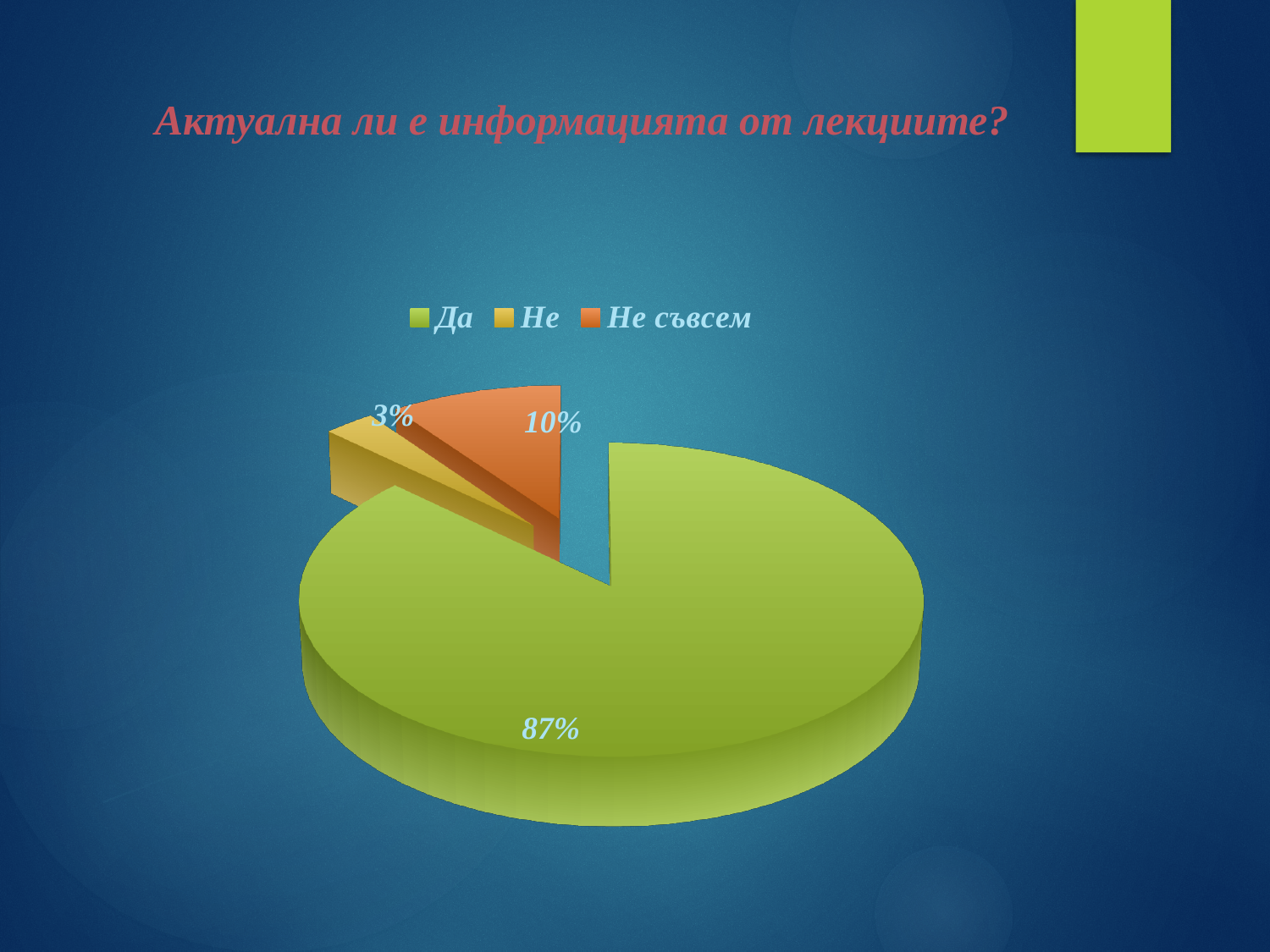
What share of the pie does the "Не" slice represent? 3% What colour is the "Не съвсем" slice? Orange What is the difference in percentage points between the "Да" and "Не съвсем" slices? 77 Which category has the largest share of the pie? Да Which category has the smallest share of the pie? Не What is the title of the chart? Актуална ли е информацията от лекциите? What kind of chart is shown on the slide? Pie chart Which slice is larger, "Не" or "Не съвсем"? Не съвсем What share of the pie does the "Да" slice represent? 87% How many slices does the pie chart have? 3 What share of the pie does the "Не съвсем" slice represent? 10% What is the difference in percentage points between the "Не съвсем" and "Не" slices? 7